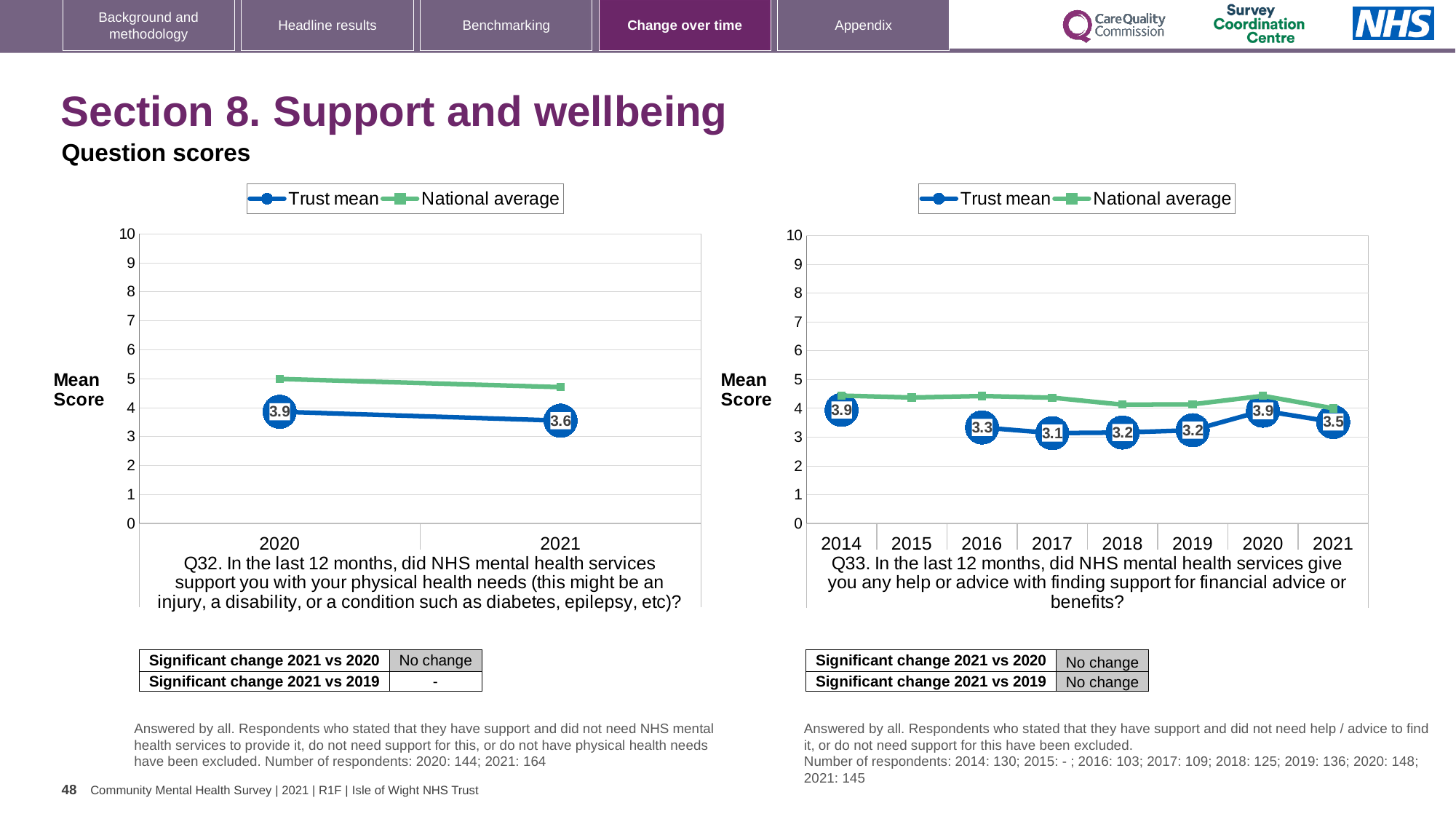
In the Q33 chart on the right, what is the difference between the Trust mean in 2020 and in 2021? 0.4 In the Q32 chart on the left, what is the Trust mean for 2020? 3.9 In the Q33 chart on the right, what is the Trust mean for 2017? 3.1 What type of chart is the Q33 chart on the right? Line chart In the Q33 chart on the right, what is the Trust mean for 2021? 3.5 In the Q32 chart on the left, how many series does the legend list? 2 In the Q32 chart on the left, is the National average for 2020 greater or less than 4? greater In the Q32 chart on the left, by how much did the Trust mean fall from 2020 to 2021? 0.3 In the Q32 chart on the left, what is the Trust mean for 2021? 3.6 In the Q33 chart on the right, which year has the lowest Trust mean? 2017 In the Q33 chart on the right, which is larger, the Trust mean for 2016 or for 2020? 2020 In the Q33 chart on the right, how many years are shown on the x axis? 8